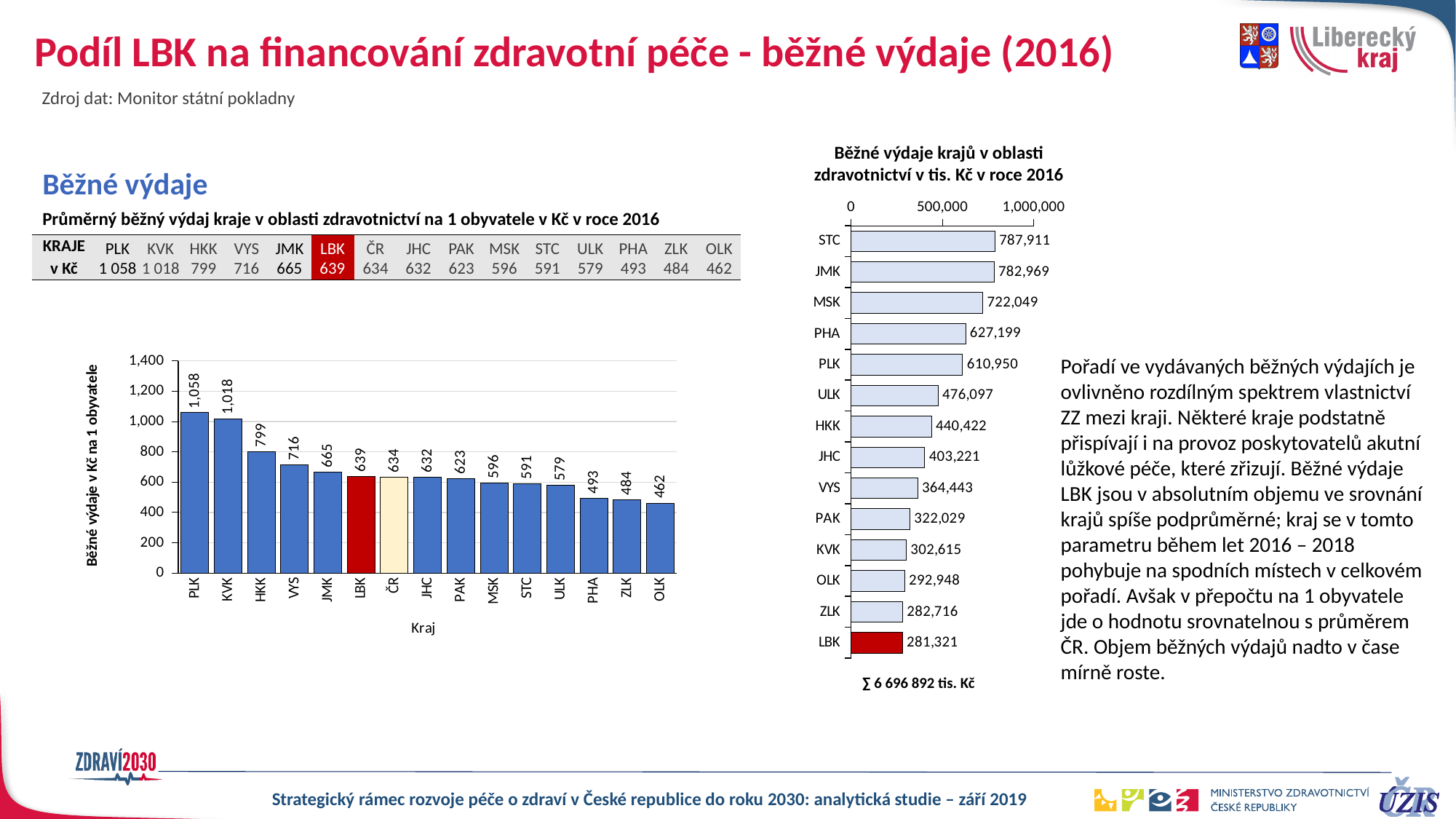
In the right chart (Běžné výdaje krajů v oblasti zdravotnictví v tis. Kč v roce 2016), what is the difference between STC and LBK? 506,590 In the left chart (Běžné výdaje v Kč na 1 obyvatele), do the values rise or fall from left to right along the x axis? fall In the left chart (Běžné výdaje v Kč na 1 obyvatele), which region has the lowest value? OLK In the right chart (Běžné výdaje krajů v oblasti zdravotnictví v tis. Kč v roce 2016), how many regions are plotted? 14 In the left chart (Běžné výdaje v Kč na 1 obyvatele), how many bars are plotted? 15 In the left chart (Běžné výdaje v Kč na 1 obyvatele), what is the value for LBK? 639 In the left chart (Běžné výdaje v Kč na 1 obyvatele), what is the difference between PLK and OLK? 596 In the right chart (Běžné výdaje krajů v oblasti zdravotnictví v tis. Kč v roce 2016), what is the value for LBK? 281,321 What type of chart is the right chart (Běžné výdaje krajů v oblasti zdravotnictví v tis. Kč v roce 2016)? bar chart In the left chart (Běžné výdaje v Kč na 1 obyvatele), which region has the highest value? PLK In the right chart (Běžné výdaje krajů v oblasti zdravotnictví v tis. Kč v roce 2016), which region has the highest value? STC In the right chart (Běžné výdaje krajů v oblasti zdravotnictví v tis. Kč v roce 2016), which is larger, the value for PHA or the value for ULK? PHA